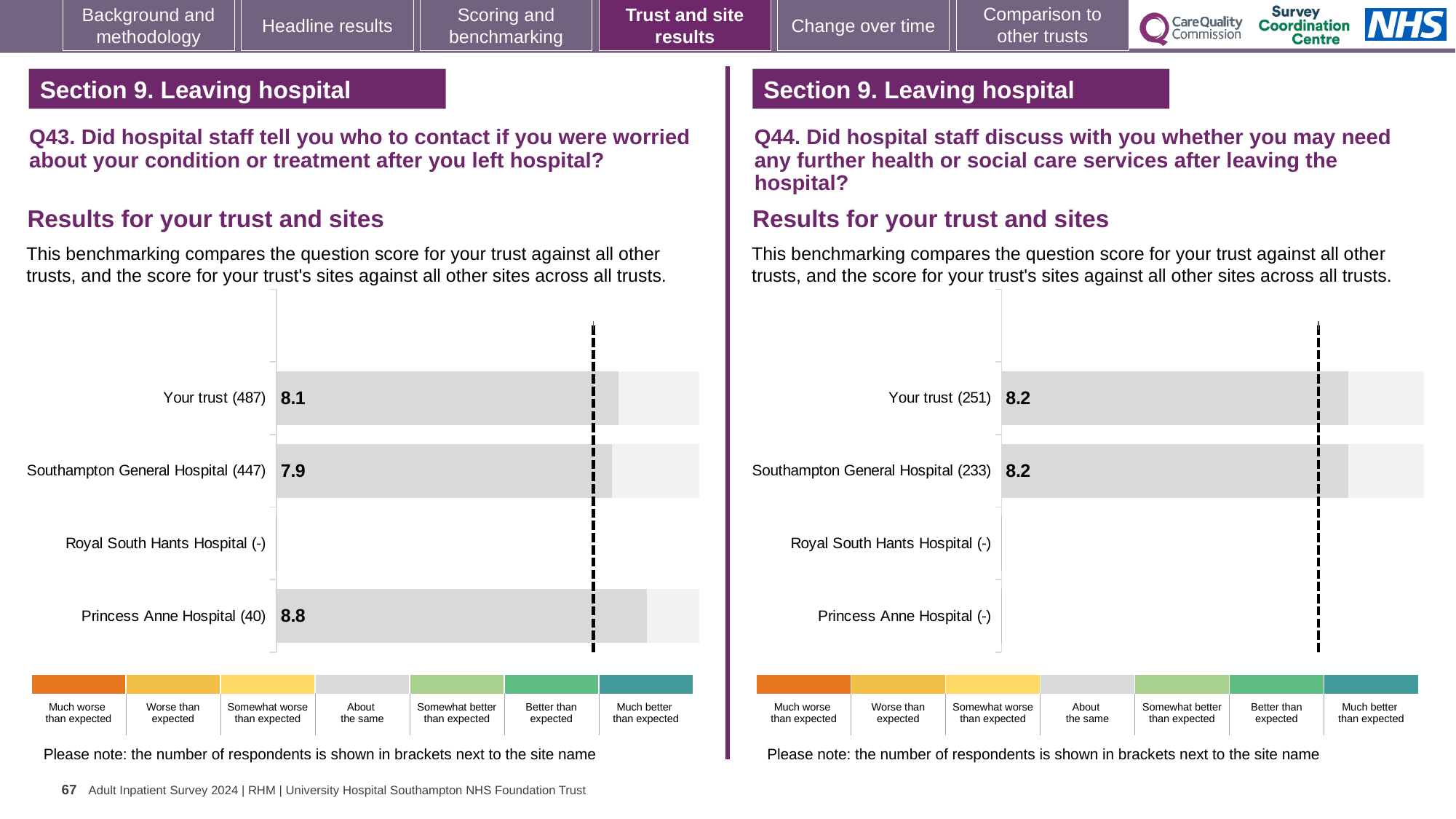
In the Q43 chart on the left, what is the score for Your trust? 8.1 In the Q43 chart on the left, which site has the highest score? Princess Anne Hospital How many rows (categories) are listed on the y axis of the Q44 chart on the right? 4 In the Q44 chart on the right, what is the score for Your trust? 8.2 In the Q44 chart on the right, how many respondents are shown for Your trust? 251 What kind of chart is used in the Q43 chart on the left? Bar chart In the Q43 chart on the left, which of the plotted rows has the lowest score? Southampton General Hospital In the Q43 chart on the left, how many respondents are shown for Princess Anne Hospital? 40 In the Q43 chart on the left, what is the score for Princess Anne Hospital? 8.8 In the Q44 chart on the right, what is the score for Southampton General Hospital? 8.2 In the Q43 chart on the left, what is the difference between the scores for Princess Anne Hospital and Your trust? 0.7 In the Q43 chart on the left, what is the score for Southampton General Hospital? 7.9